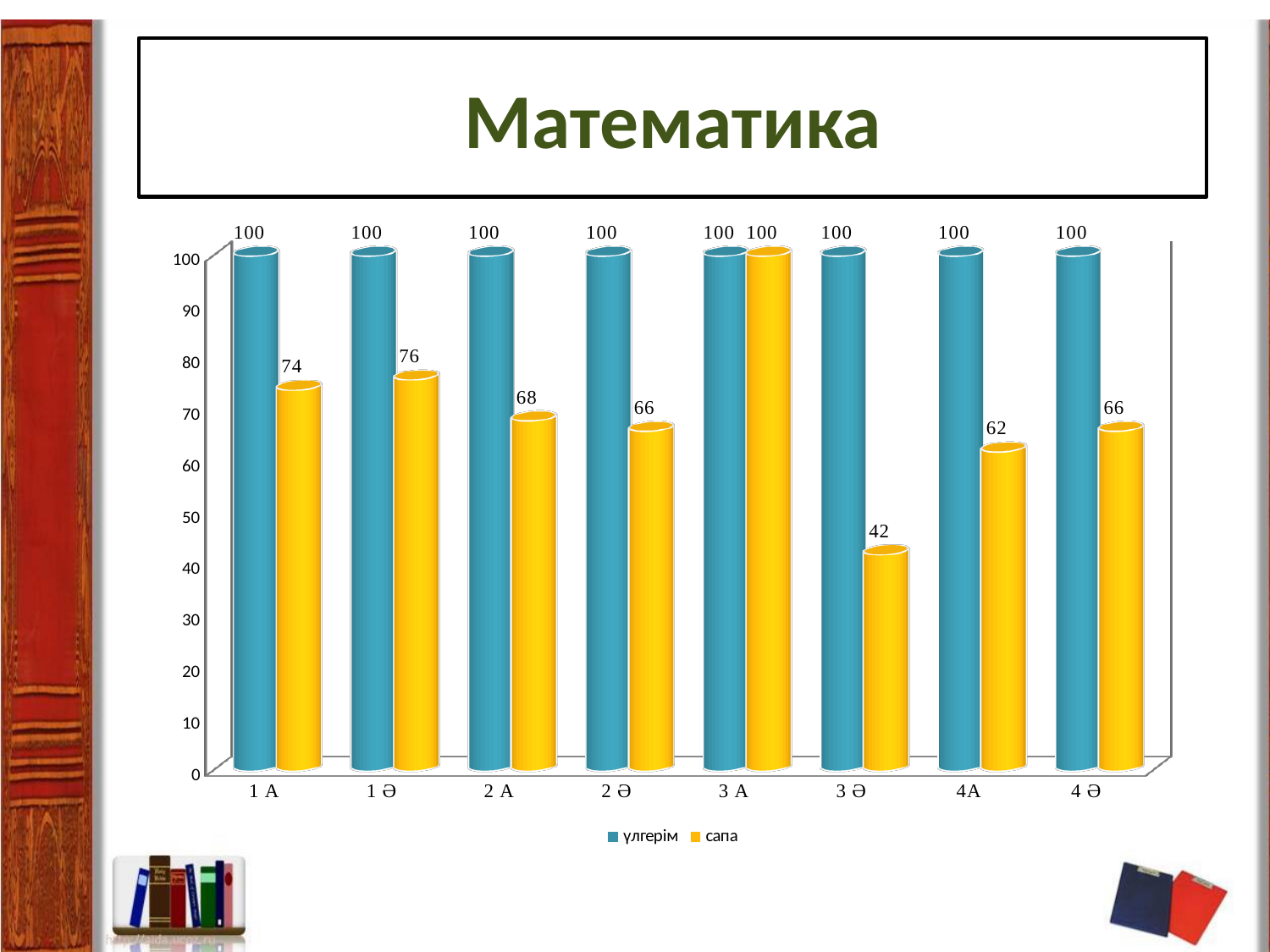
How many categories are shown on the x axis? 8 What is the difference between the сапа values for 1 Ә and 3 Ә? 34 What is the difference between the үлгерім and сапа values for 1 А? 26 Which category has the highest сапа value? 3 А What is the title of the slide? Математика Which category has the lowest сапа value? 3 Ә What kind of chart is shown on the slide? bar chart How many series does the legend list? 2 What is the сапа value for 3 Ә? 42 Which is larger, the сапа value for 2 А or for 4А? 2 А What is the сапа value for 1 Ә? 76 What is the үлгерім value for 2 А? 100